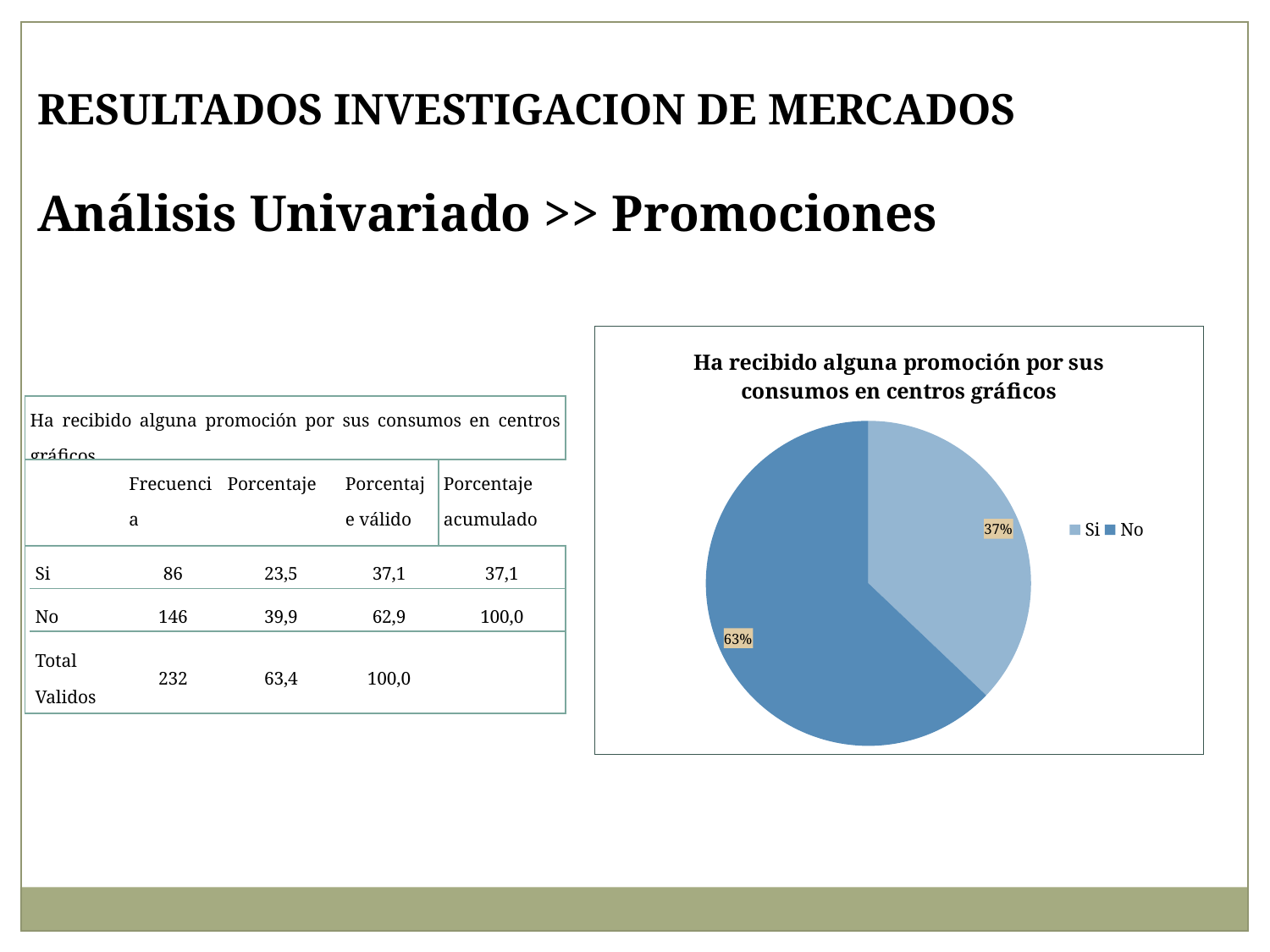
What share of the pie does the 'Si' slice represent? 37% Which slice of the pie chart is the smallest? Si Is the share of the 'Si' slice greater or less than 50%? less What is the title of the pie chart? Ha recibido alguna promoción por sus consumos en centros gráficos What share of the pie does the 'No' slice represent? 63% Which legend entry is shown in the darker blue colour? No What is the difference in percentage points between the 'No' slice and the 'Si' slice? 26% Which slice of the pie chart is the largest? No Which is larger in the pie chart, the 'Si' slice or the 'No' slice? No What kind of chart is shown on the slide? pie chart How many entries does the legend of the pie chart list? 2 How many slices does the pie chart have? 2